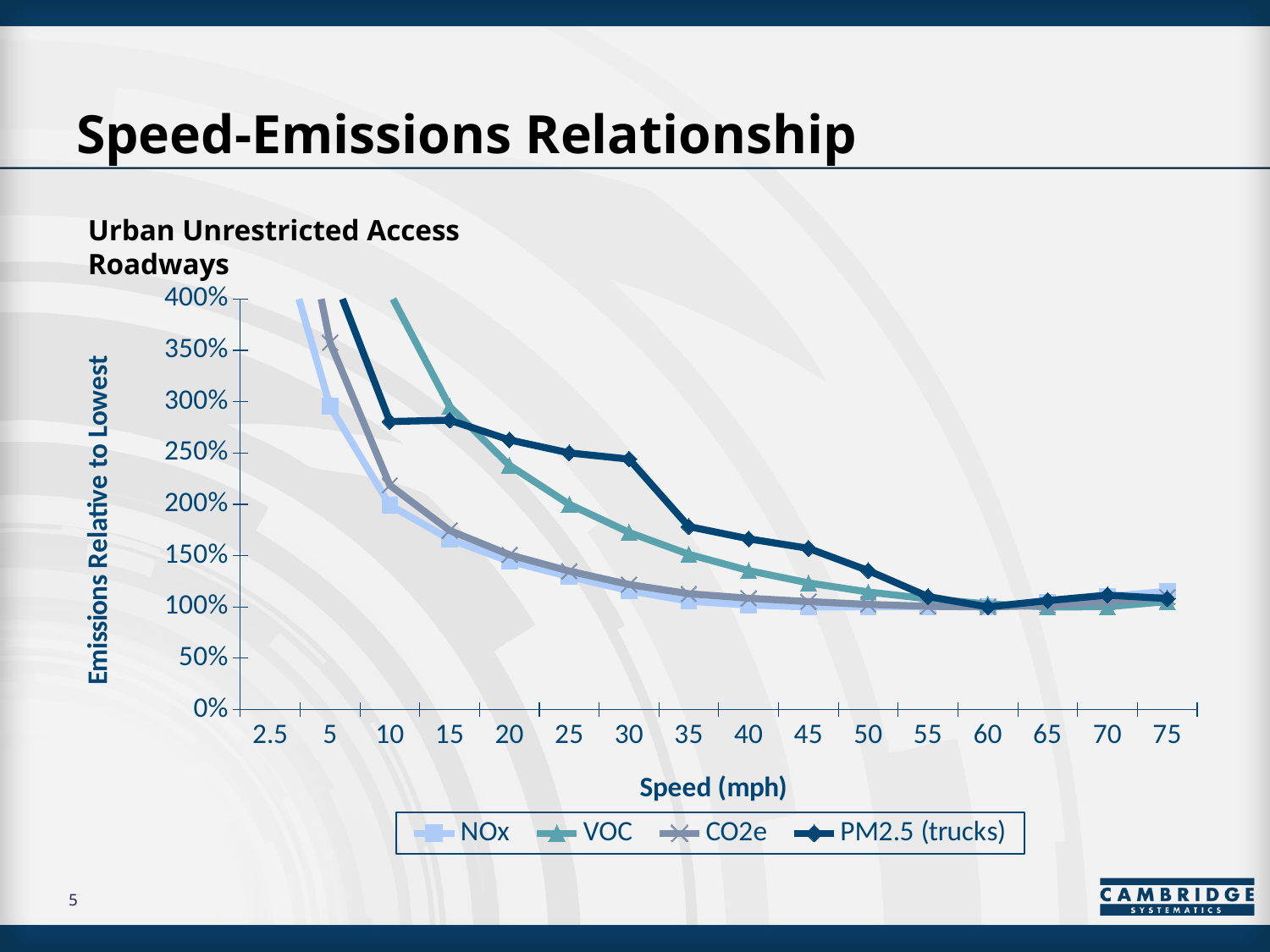
At 25 mph, which is larger: the value for VOC or the value for CO2e? VOC Is the value for CO2e at 5 mph greater or less than 300%? greater At 30 mph, which is larger: the value for PM2.5 (trucks) or the value for NOx? PM2.5 (trucks) Is the value for PM2.5 (trucks) at 10 mph greater or less than 250%? greater Do the emissions values generally rise or fall as speed increases from 5 mph to 60 mph? fall How many series does the legend list? 4 Is the value for NOx at 10 mph greater or less than 250%? less How many speed values are marked along the x axis? 16 Which series has the highest value at 30 mph? PM2.5 (trucks) What kind of chart is shown on the slide? line chart What is the label on the y axis of the chart? Emissions Relative to Lowest